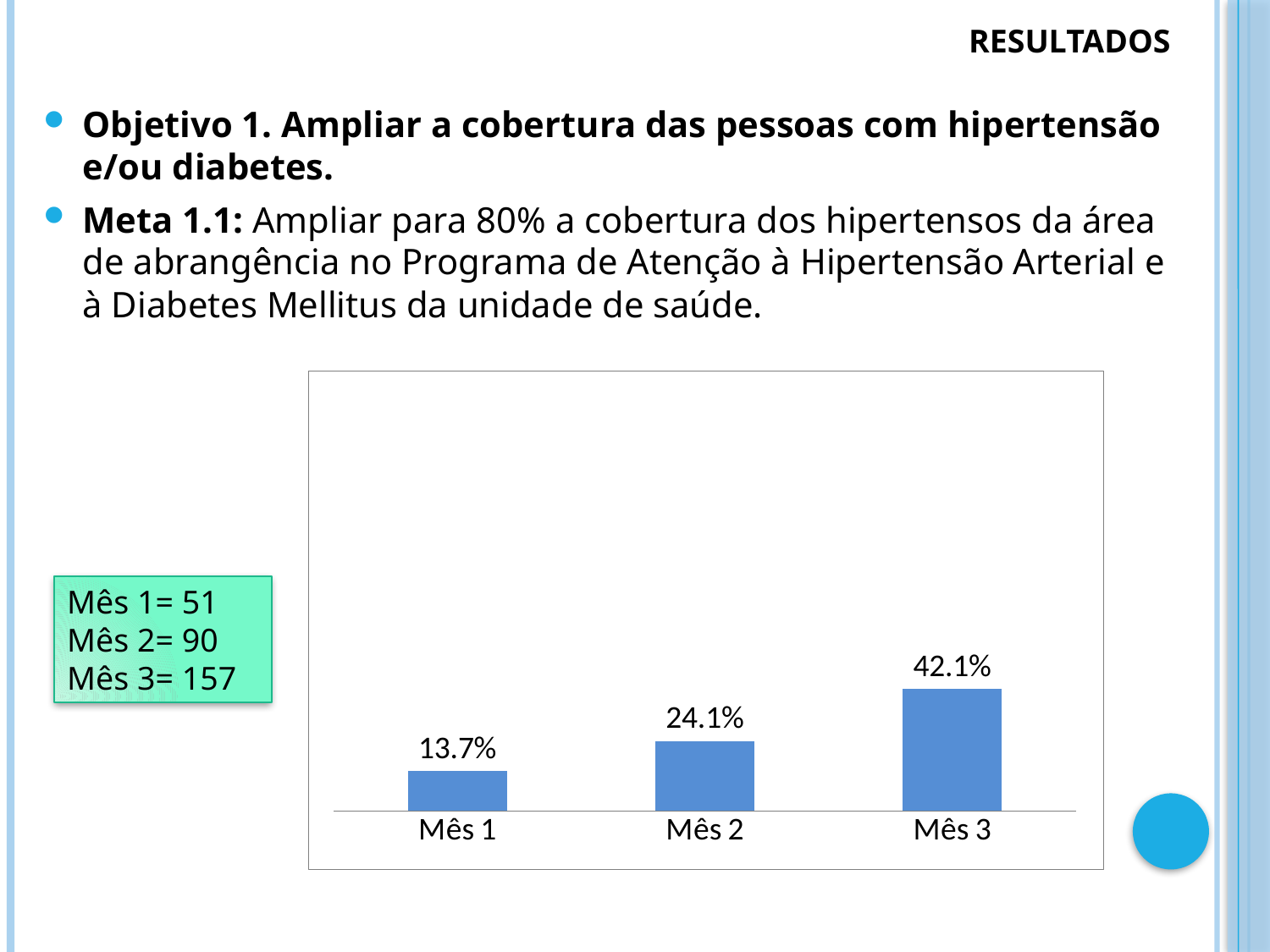
What is the difference between the values for Mês 3 and Mês 1? 28.4% Which month has the lowest value? Mês 1 Which is larger, the value for Mês 2 or the value for Mês 3? Mês 3 What is the value for Mês 3? 42.1% Which month has the highest value? Mês 3 Do the values rise or fall from Mês 1 to Mês 3? rise How many categories are shown on the x axis of the chart? 3 What kind of chart is shown on the slide? bar chart What is the value for Mês 2? 24.1% What colour are the bars in the chart? blue What is the difference between the values for Mês 2 and Mês 1? 10.4% What is the value for Mês 1? 13.7%